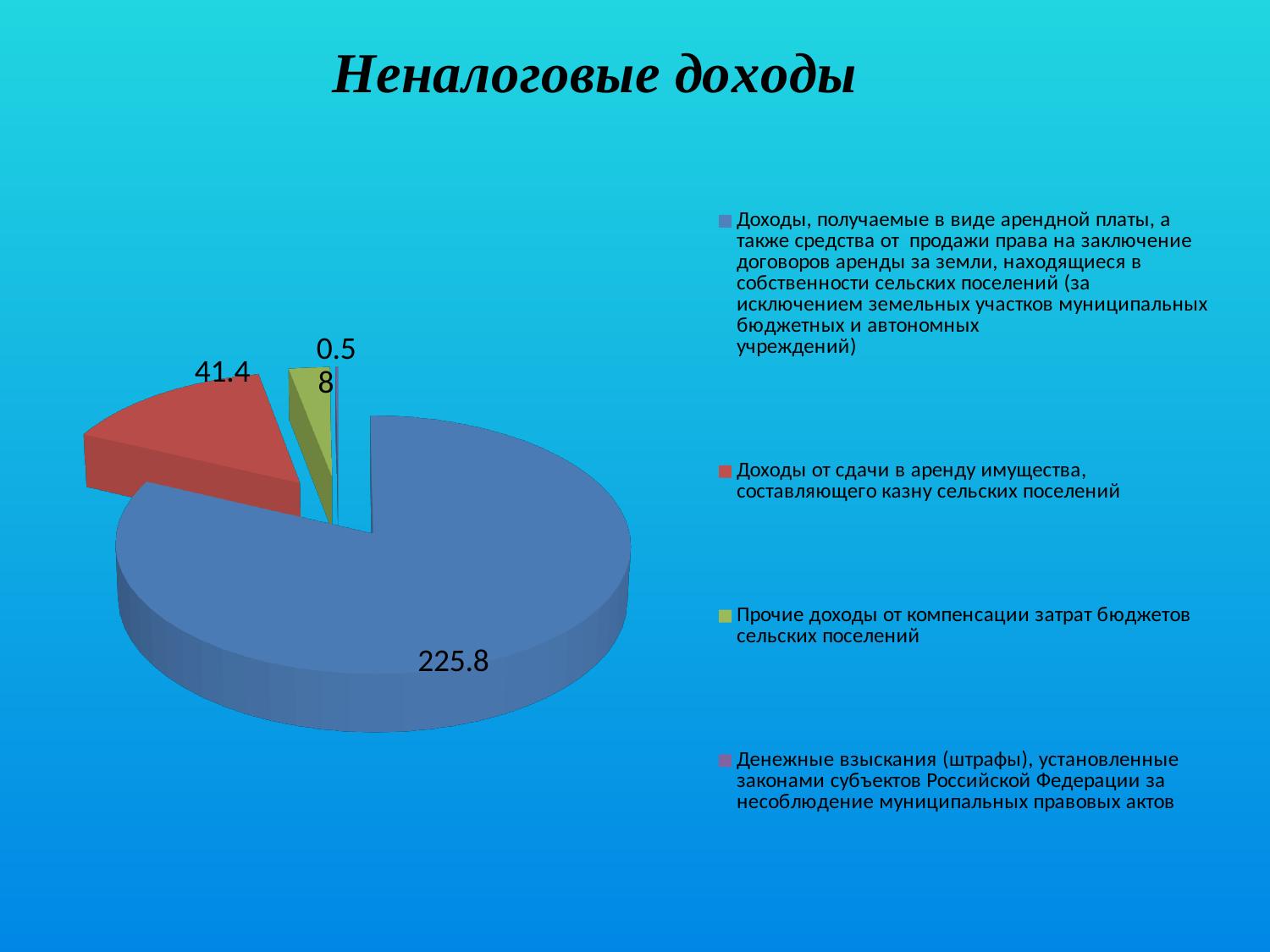
What is the value for "Доходы от сдачи в аренду имущества, составляющего казну сельских поселений"? 41.4 What is the value for "Прочие доходы от компенсации затрат бюджетов сельских поселений"? 8 How many slices does the pie chart have? 4 Which is larger: the value for "Прочие доходы от компенсации затрат бюджетов сельских поселений" or the value for "Денежные взыскания (штрафы)"? Прочие доходы от компенсации затрат бюджетов сельских поселений What is the value for "Денежные взыскания (штрафы), установленные законами субъектов Российской Федерации за несоблюдение муниципальных правовых актов"? 0.5 What is the title of the chart on the slide? Неналоговые доходы What type of chart is shown on the slide? Pie chart What is the value of the largest slice, the income from rent payments and sale of rights to conclude land lease agreements (Доходы, получаемые в виде арендной платы...)? 225.8 Which category has the largest value in the pie chart? Доходы, получаемые в виде арендной платы, а также средства от продажи права на заключение договоров аренды за земли, находящиеся в собственности сельских поселений How many entries does the legend list? 4 Which category has the smallest value in the pie chart? Денежные взыскания (штрафы), установленные законами субъектов Российской Федерации за несоблюдение муниципальных правовых актов What is the difference between the value for "Доходы от сдачи в аренду имущества, составляющего казну сельских поселений" and the value for "Прочие доходы от компенсации затрат бюджетов сельских поселений"? 33.4